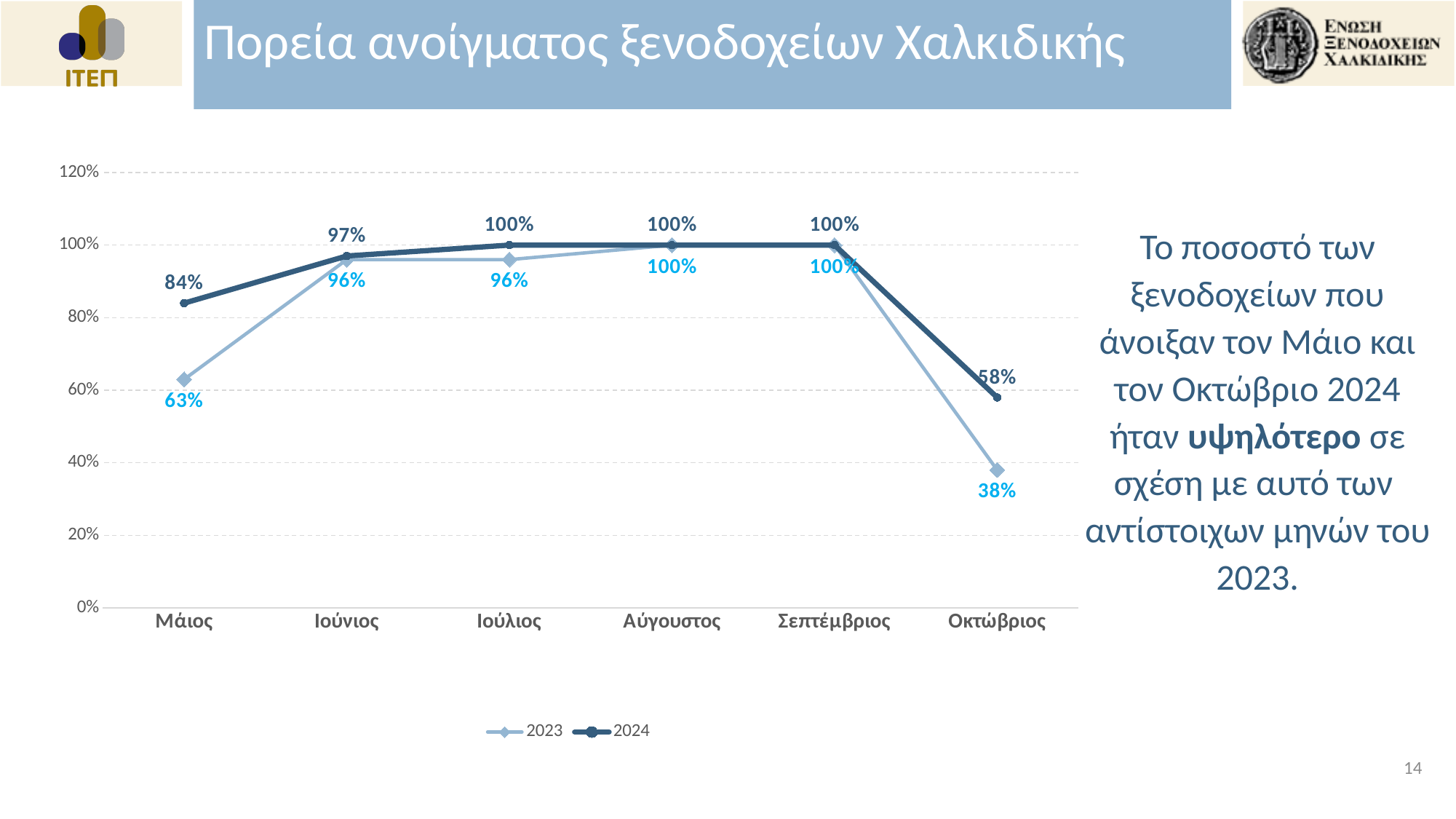
Which series has the larger value in Ιούλιος, 2023 or 2024? 2024 What is the value for 2023 in Οκτώβριος? 38% Which month has the lowest value for the 2023 series? Οκτώβριος What is the value for 2024 in Μάιος? 84% What is the difference between the 2024 and 2023 values in Οκτώβριος? 20% How many series does the legend list? 2 What is the difference between the 2024 and 2023 values in Μάιος? 21% What is the value for 2024 in Οκτώβριος? 58% What is the title of the chart slide? Πορεία ανοίγματος ξενοδοχείων Χαλκιδικής How many months are shown on the x axis? 6 What type of chart is shown on the slide? line chart What is the value for 2023 in Ιούλιος? 96%